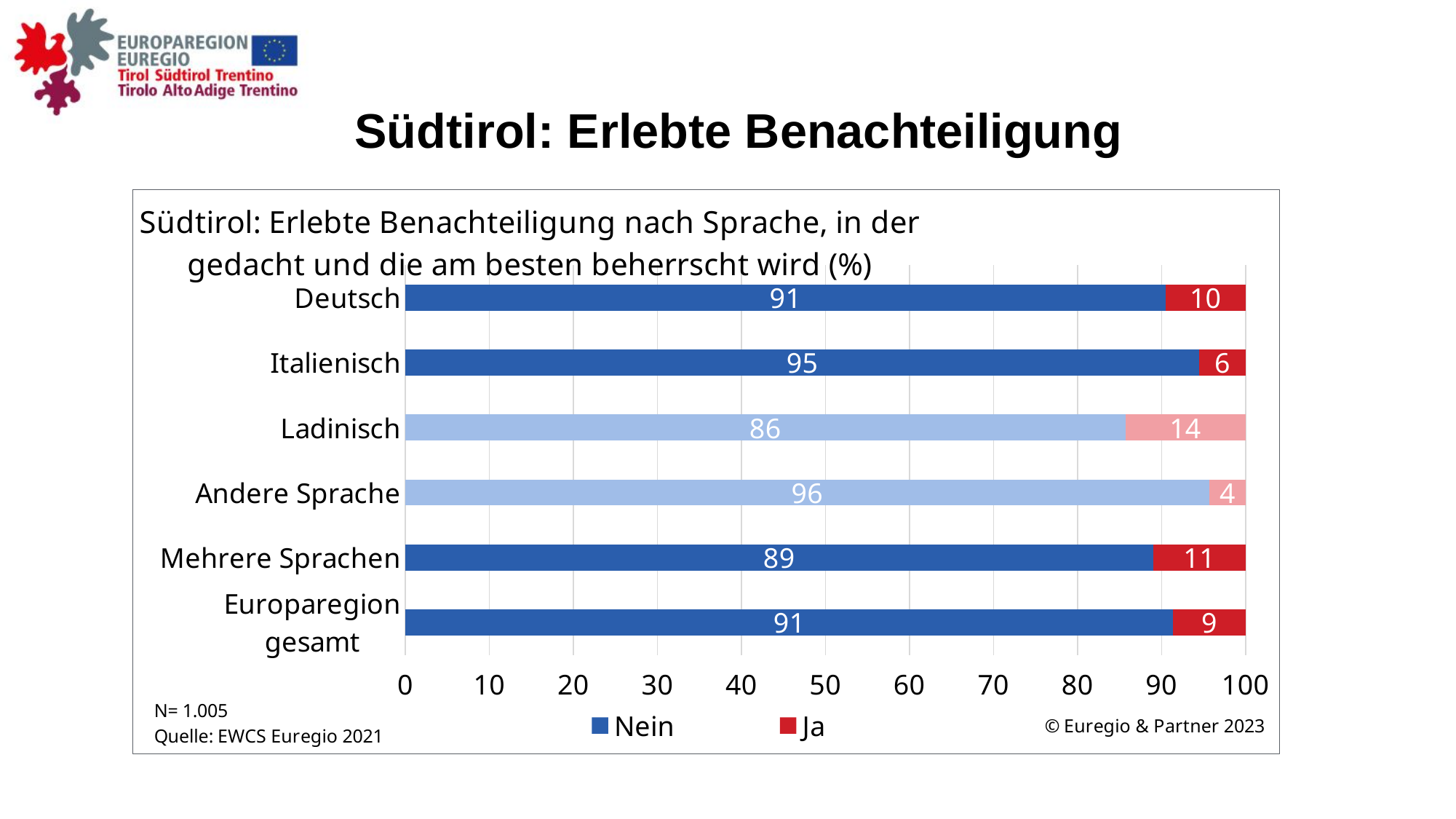
What is the 'Ja' value for Ladinisch? 14 Which category has the highest 'Ja' value? Ladinisch Which has a larger 'Ja' value, Deutsch or Italienisch? Deutsch Which category has the lowest 'Nein' value? Ladinisch What are the two legend entries of the chart? Nein and Ja How many categories are shown on the chart? 6 What is the difference between the 'Nein' values for Italienisch and Mehrere Sprachen? 6 What is the 'Nein' value for Deutsch? 91 What is the 'Ja' value for Andere Sprache? 4 How many series does the legend list? 2 What is the 'Nein' value for Europaregion gesamt? 91 What kind of chart is shown? Stacked bar chart